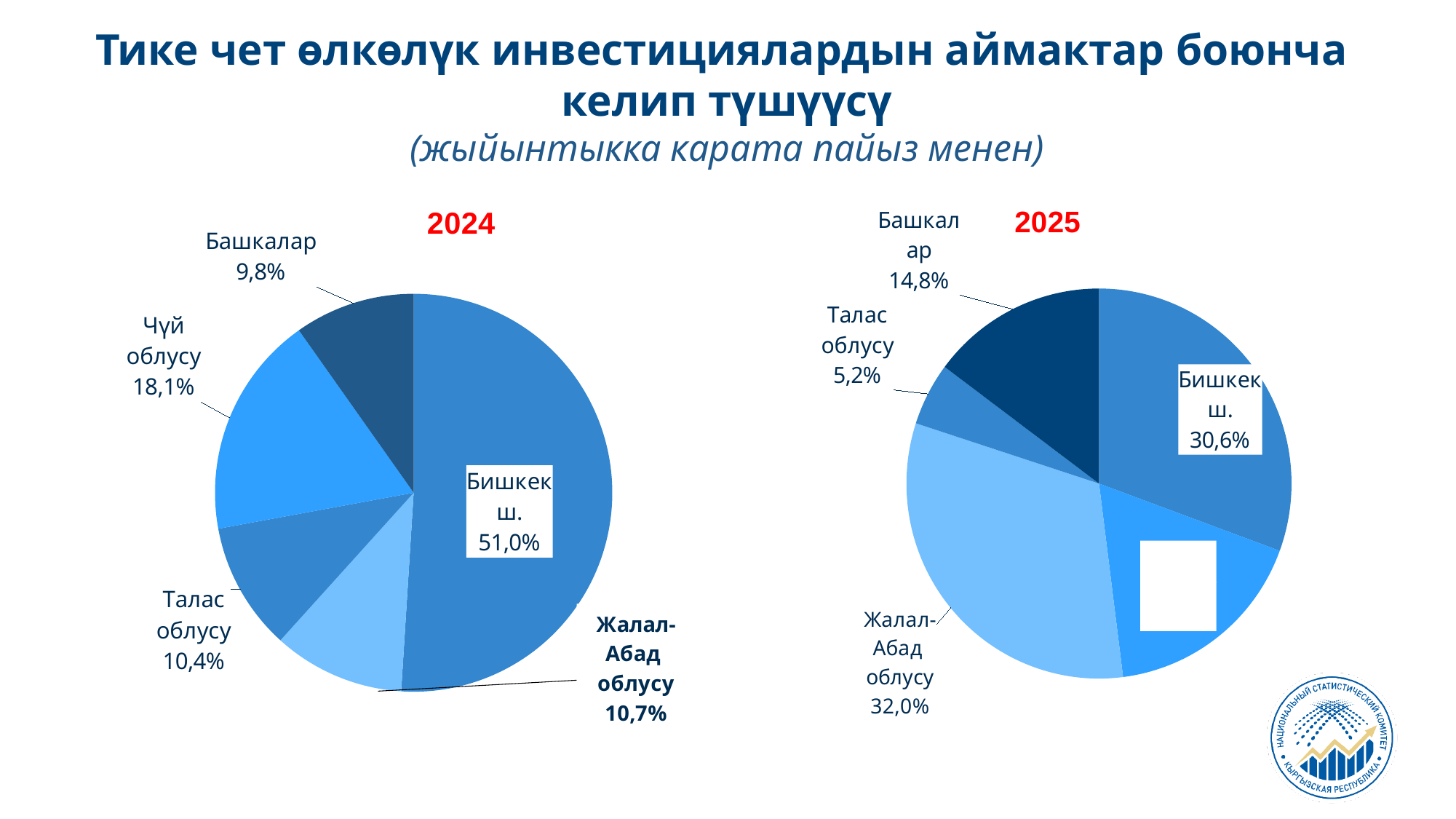
In the 2024 pie chart, what is the value for Чүй облусу? 18,1% In the 2024 pie chart, which category has the largest share? Бишкек ш. In the 2025 pie chart, what share does Жалал-Абад облусу have? 32,0% In the 2025 pie chart, which is larger: Жалал-Абад облусу or Бишкек ш.? Жалал-Абад облусу How many slices does the 2024 pie chart have? 5 In the 2025 pie chart, which labelled category has the smallest share? Талас облусу In the 2024 pie chart, which labelled category has the smallest share? Башкалар In the 2024 pie chart, what is the difference between Чүй облусу and Башкалар? 8,3 percentage points In the 2024 pie chart, what share does Бишкек ш. have? 51,0% What type of chart is used on this slide? Pie chart In the 2025 pie chart, what is the value for Талас облусу? 5,2% What is the difference between the share of Бишкек ш. in 2024 and in 2025? 20,4 percentage points